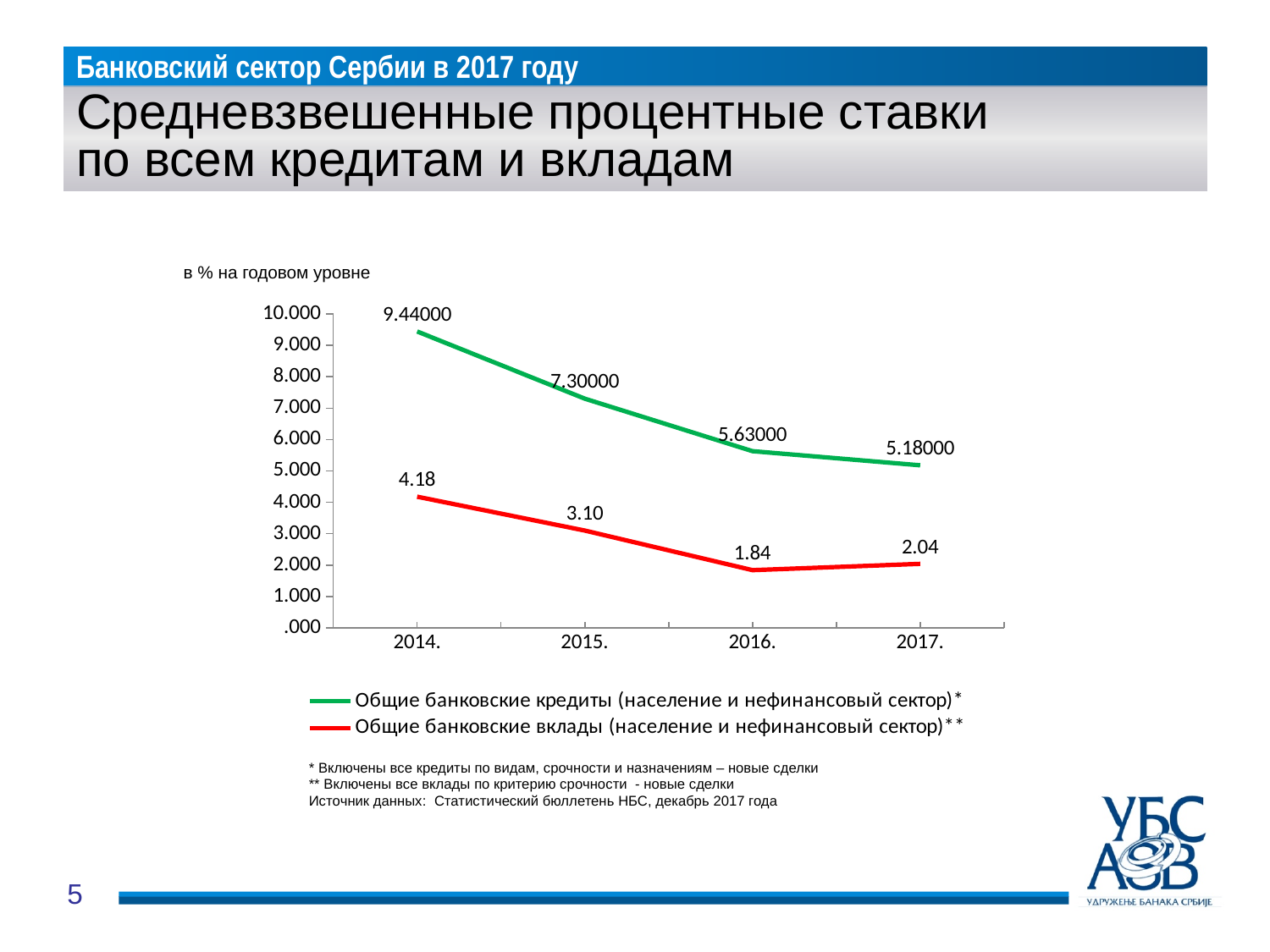
What is the value for total bank loans (Общие банковские кредиты) in 2014? 9.44000 What is the value for total bank deposits (Общие банковские вклады) in 2015? 3.10 Which is larger in 2017: the loan rate or the deposit rate? the loan rate (5.18000) What is the value for total bank deposits (Общие банковские вклады) in 2016? 1.84 What is the difference between the loan rate in 2014 (9.44000) and in 2017 (5.18000)? 4.26000 In which year is the loan rate (Общие банковские кредиты) highest? 2014. How many years are shown on the x axis? 4 How many series does the legend list? 2 In which year is the deposit rate (Общие банковские вклады) lowest? 2016. Does the loan rate (Общие банковские кредиты) rise or fall from 2014 to 2017? fall What is the value for total bank loans (Общие банковские кредиты) in 2017? 5.18000 What type of chart is shown on the slide? line chart